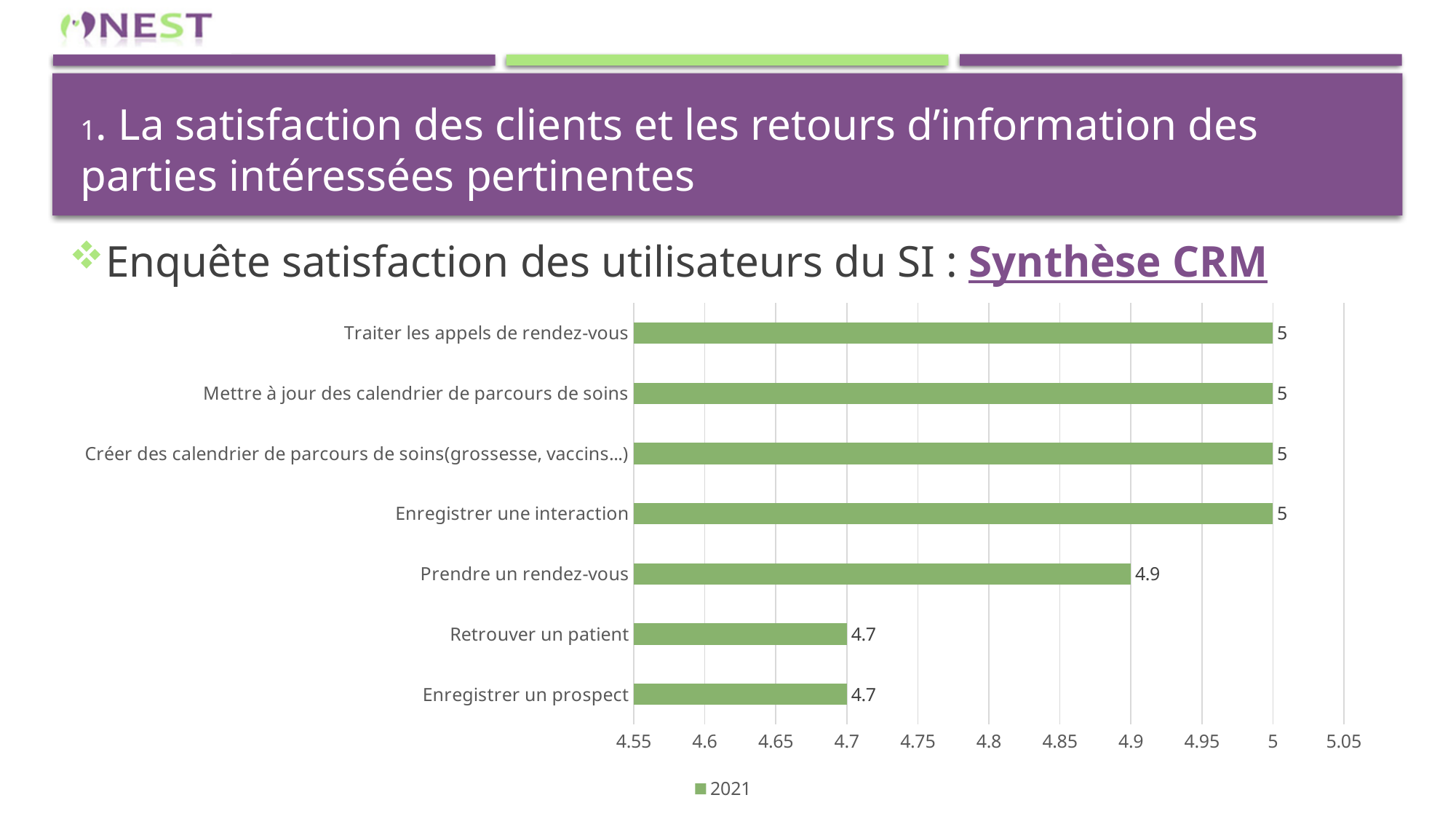
Is the value for "Prendre un rendez-vous" greater or less than 4.8? greater How many categories are shown in the chart? 7 What kind of chart is shown on the slide? bar chart What is the value for "Prendre un rendez-vous"? 4.9 Which is larger, the value for "Prendre un rendez-vous" or the value for "Retrouver un patient"? Prendre un rendez-vous What is the difference between the values for "Traiter les appels de rendez-vous" and "Enregistrer un prospect"? 0.3 What is the difference between the values for "Prendre un rendez-vous" and "Retrouver un patient"? 0.2 What is the value for "Enregistrer une interaction"? 5 How many series does the legend list? 1 What series name is shown in the chart legend? 2021 What is the value for "Retrouver un patient"? 4.7 What is the value for "Enregistrer un prospect"? 4.7